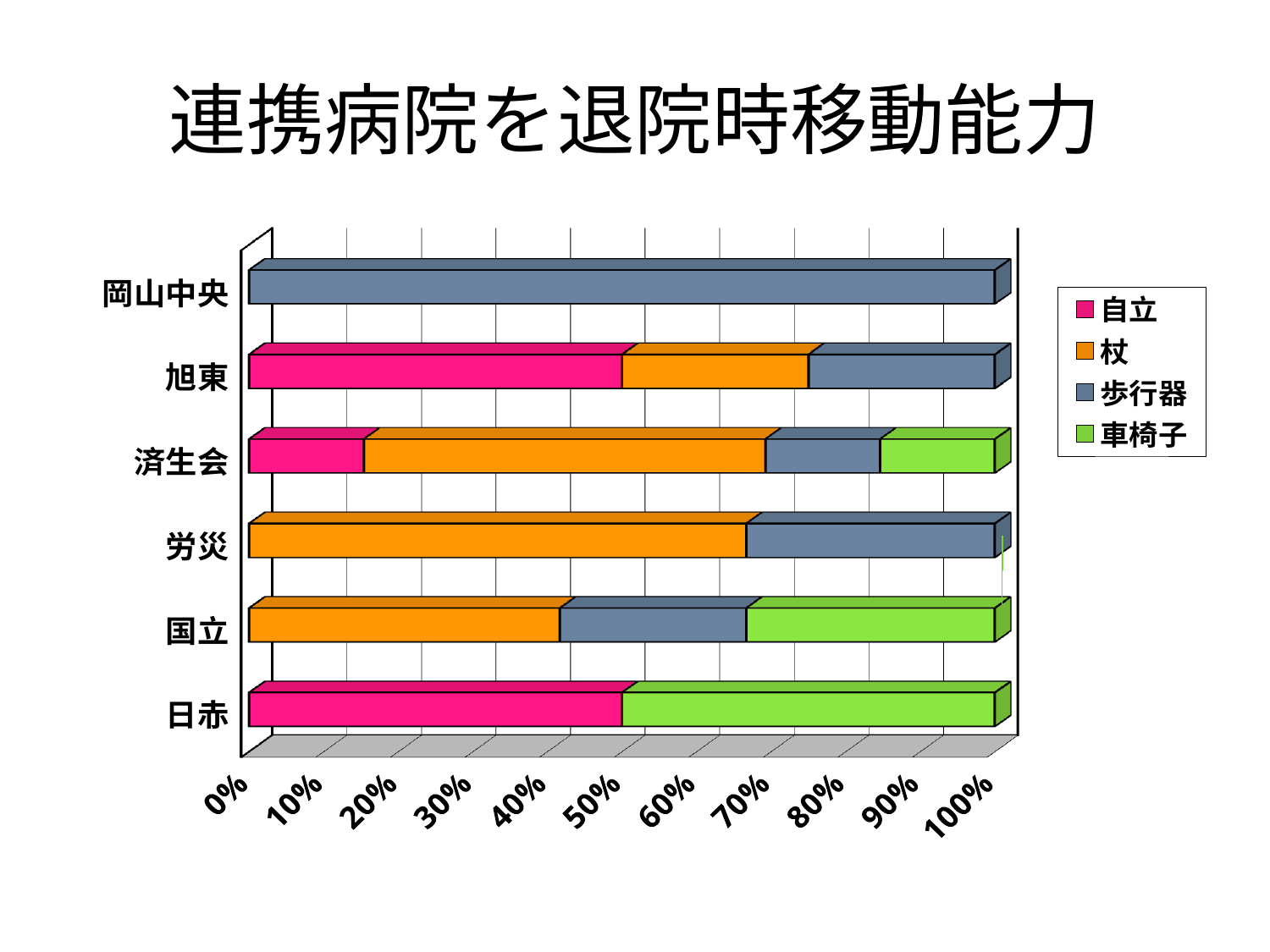
For 済生会, which is larger: the 杖 share or the 自立 share? 杖 How many hospitals (categories) are shown on the chart? 6 Which hospital has the largest 杖 share? 労災 Is the 杖 share for 国立 greater or less than 50%? less Is the 自立 share for 済生会 greater or less than 20%? less Is the 自立 share for 旭東 greater or less than 40%? greater How many series does the legend list? 4 What kind of chart is shown on the slide? Stacked bar chart Which legend entry is shown in green? 車椅子 What is the title of the chart on the slide? 連携病院を退院時移動能力